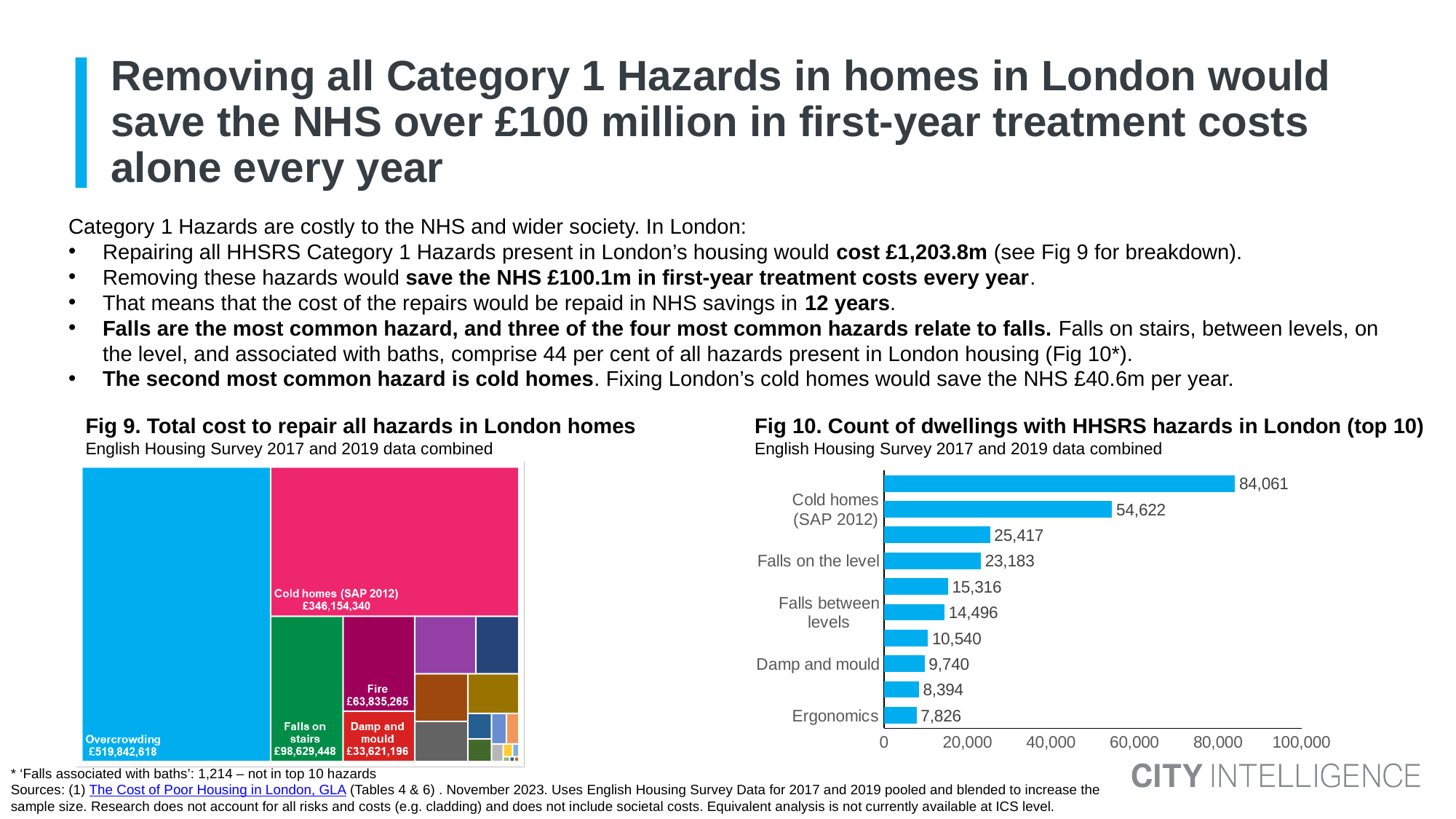
In Fig 10, what is the value shown for Damp and mould? 9,740 In Fig 10, what is the difference between the counts for Cold homes (SAP 2012) and Falls on the level? 31,439 In Fig 9, which hazard has the highest total repair cost? Overcrowding In Fig 9, what is the repair cost shown for Fire? £63,835,265 In Fig 10, how many bars are plotted? 10 In Fig 10, is the value for Cold homes (SAP 2012) greater or less than 40,000? greater In Fig 10, which has the larger count: Falls between levels or Damp and mould? Falls between levels In Fig 9, what is the total cost to repair Overcrowding? £519,842,618 What kind of chart is Fig 10? Bar chart In Fig 10, what is the count of dwellings for Ergonomics? 7,826 In Fig 10, what is the count of dwellings for Falls on the level? 23,183 In Fig 10, how many dwellings have the Cold homes (SAP 2012) hazard? 54,622